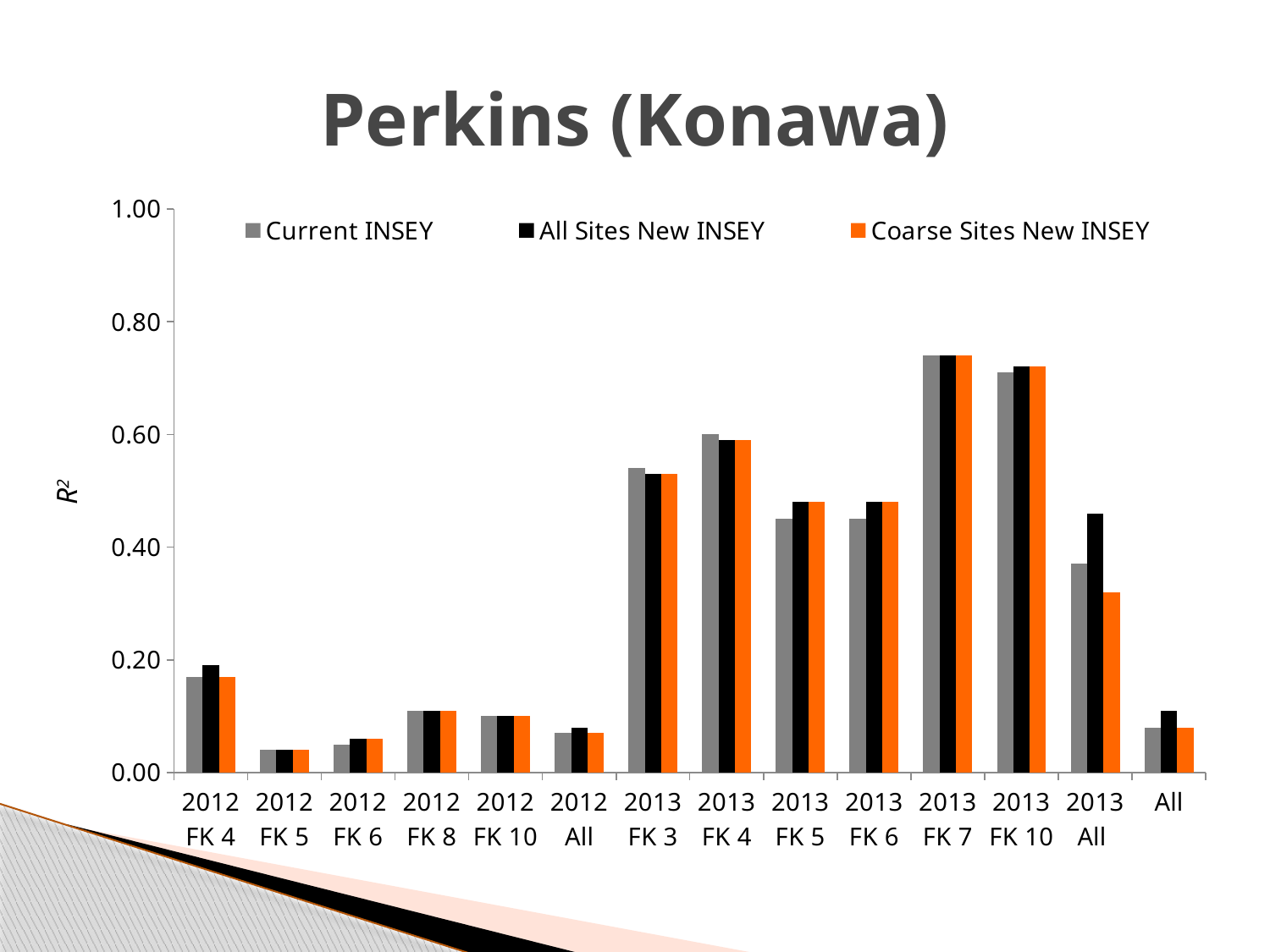
Is the Coarse Sites New INSEY value for 2013 All greater or less than 0.40? less What kind of chart is shown on the slide? bar chart How many categories are shown along the x axis? 14 Is the All Sites New INSEY value for 2013 All greater or less than 0.40? greater Which category has the highest Current INSEY value? 2013 FK 7 Which series is shown in orange? Coarse Sites New INSEY Which category has the lowest Current INSEY value? 2012 FK 5 Is the Current INSEY value for 2013 FK 7 greater or less than 0.60? greater For 2013 All, which is larger: the All Sites New INSEY value or the Coarse Sites New INSEY value? All Sites New INSEY What is the title of the chart? Perkins (Konawa) How many series does the legend list? 3